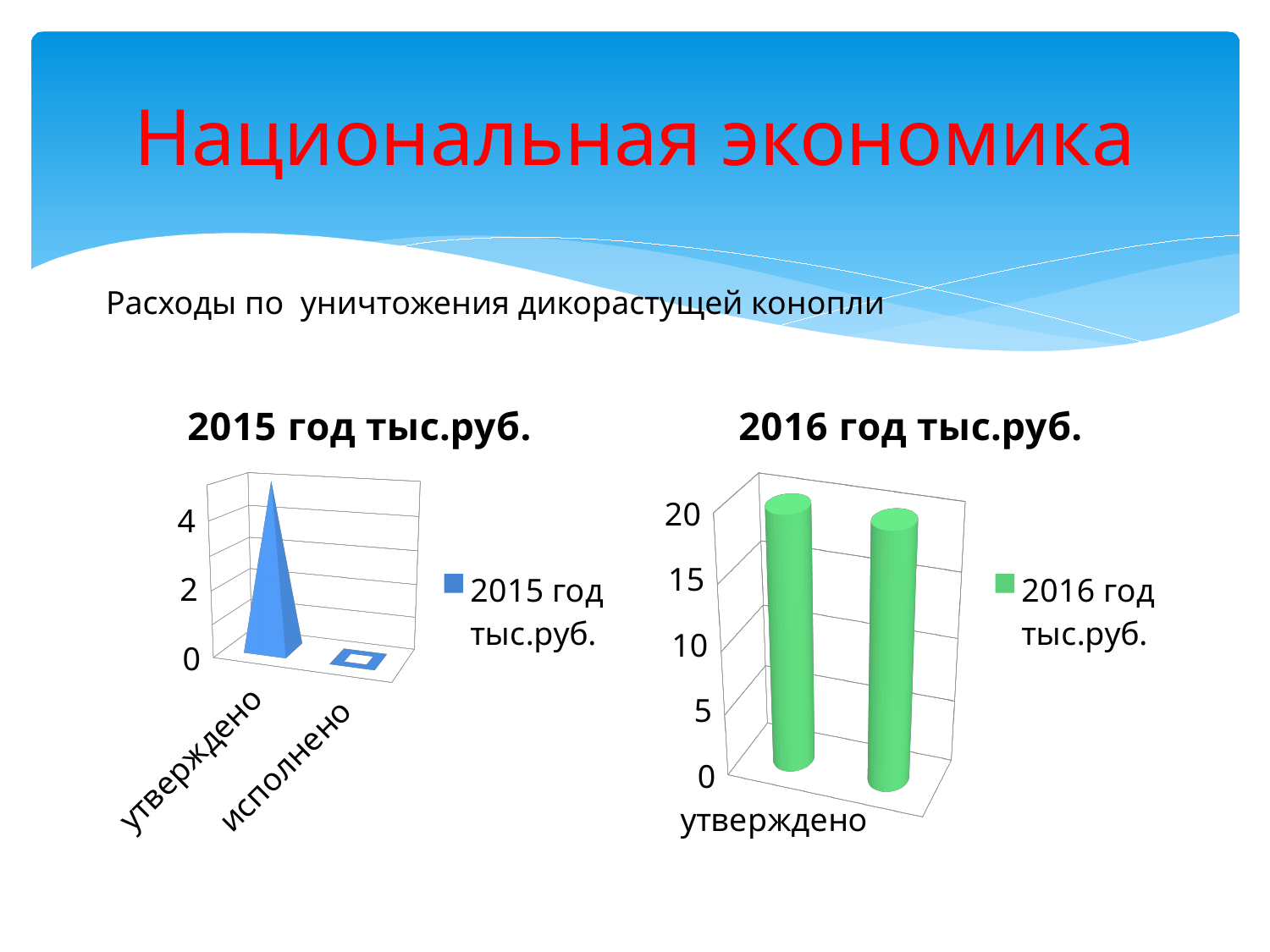
In the "2015 год тыс.руб." chart, which category has the highest value? утверждено What is the legend entry of the "2015 год тыс.руб." chart? 2015 год тыс.руб. In the "2015 год тыс.руб." chart, which category has the lowest value? исполнено In the "2015 год тыс.руб." chart, is the value for утверждено greater or less than 4? greater In the "2016 год тыс.руб." chart, is the value for утверждено greater or less than 15? greater What kind of chart is the "2015 год тыс.руб." chart on the left? bar chart How many categories are shown on the x axis of the "2015 год тыс.руб." chart? 2 What kind of chart is the "2016 год тыс.руб." chart on the right? bar chart In the "2015 год тыс.руб." chart, which is larger: утверждено or исполнено? утверждено How many series does the legend of the "2016 год тыс.руб." chart list? 1 How many bars are plotted in the "2016 год тыс.руб." chart? 2 In the "2015 год тыс.руб." chart, what is the value for исполнено? 0